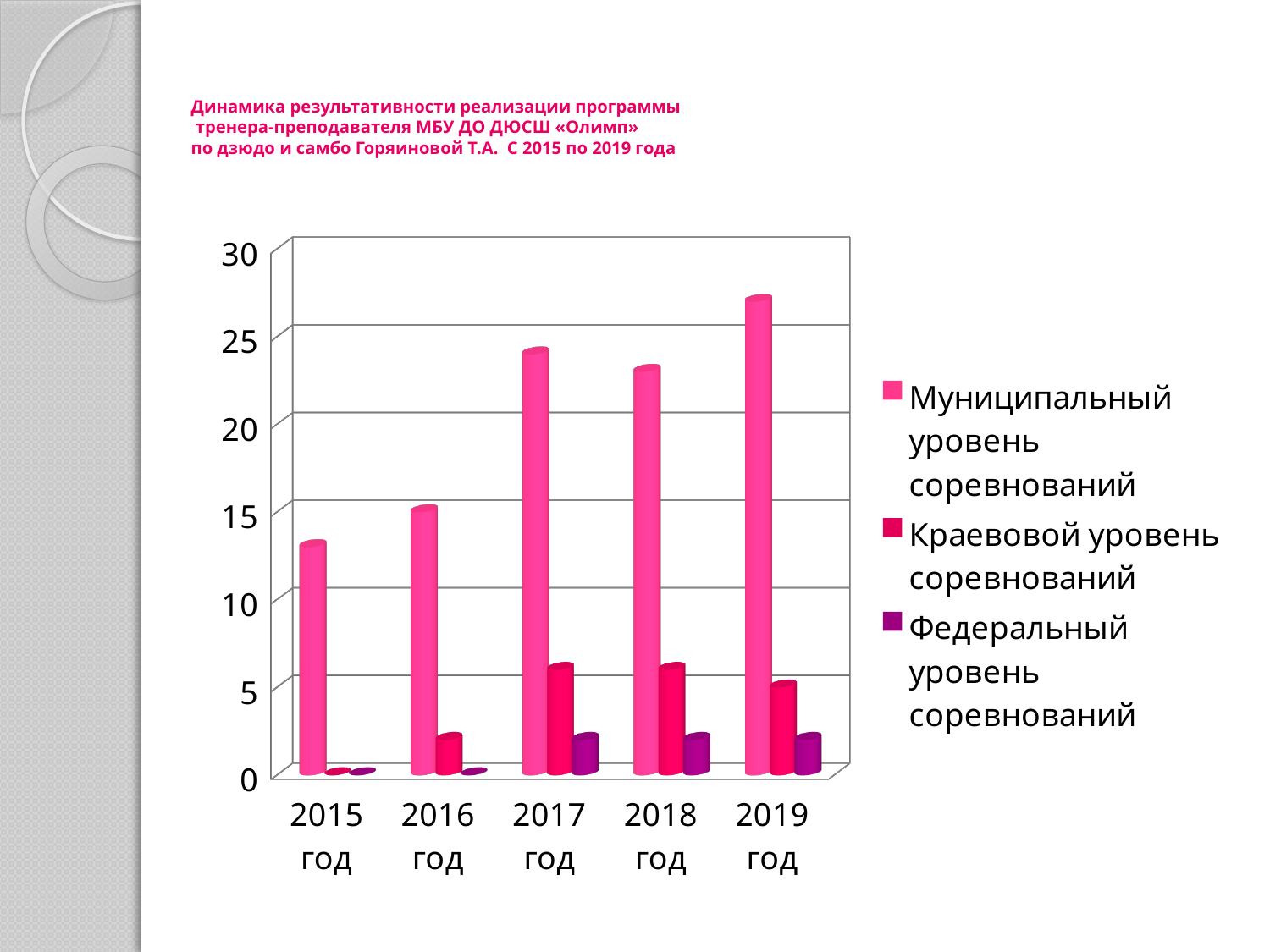
Which series is shown in the darkest purple colour in the legend? Федеральный уровень соревнований Is the value for Муниципальный уровень соревнований in 2018 год greater or less than 25? less In which year is the value for Муниципальный уровень соревнований the highest? 2019 год What kind of chart is shown on the slide? bar chart Is the value for Краевовой уровень соревнований in 2017 год greater or less than 5? greater In which year is the value for Муниципальный уровень соревнований the lowest? 2015 год Which is larger: the value for Муниципальный уровень соревнований in 2019 год or in 2015 год? 2019 год Is the value for Муниципальный уровень соревнований in 2015 год greater or less than 10? greater How many series does the chart's legend list? 3 Which is larger: the value for Краевовой уровень соревнований in 2017 год or in 2016 год? 2017 год How many years (categories) are shown on the x axis of the chart? 5